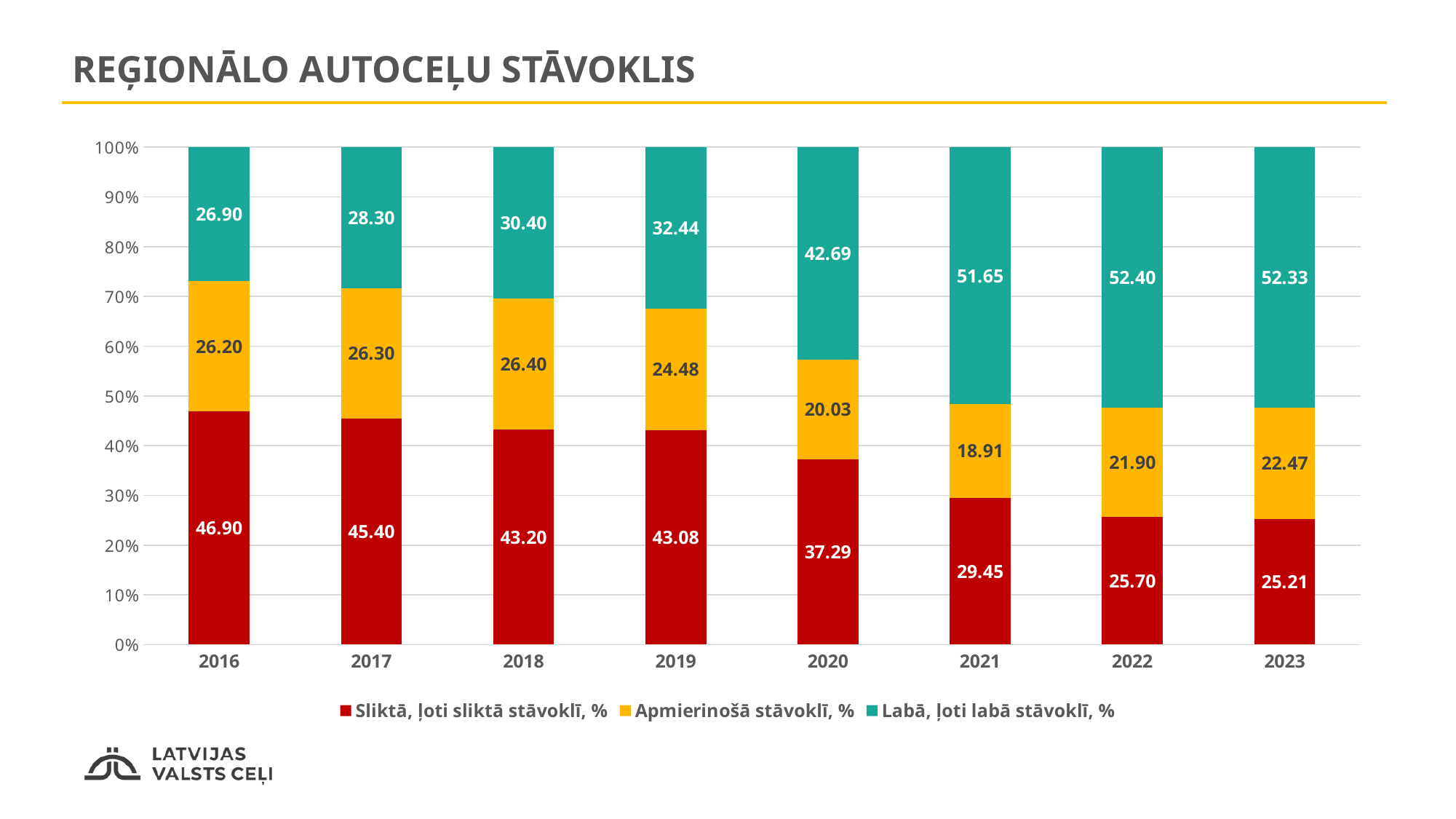
What kind of chart is shown on the slide? Stacked bar chart How many series does the legend list? 3 What is the value for "Labā, ļoti labā stāvoklī, %" in 2023? 52.33 In 2020, which is larger: the "Labā, ļoti labā stāvoklī, %" share or the "Sliktā, ļoti sliktā stāvoklī, %" share? Labā, ļoti labā stāvoklī, % In which year is the "Sliktā, ļoti sliktā stāvoklī, %" share the highest? 2016 What is the value for "Sliktā, ļoti sliktā stāvoklī, %" in 2020? 37.29 What is the value for "Apmierinošā stāvoklī, %" in 2019? 24.48 Does the "Sliktā, ļoti sliktā stāvoklī, %" share rise or fall from 2016 to 2023? Fall How many years are shown on the x axis? 8 What is the title of the chart? REĢIONĀLO AUTOCEĻU STĀVOKLIS What is the difference between the "Sliktā, ļoti sliktā stāvoklī, %" values for 2016 and 2023? 21.69 In which year is the "Apmierinošā stāvoklī, %" share the lowest? 2021